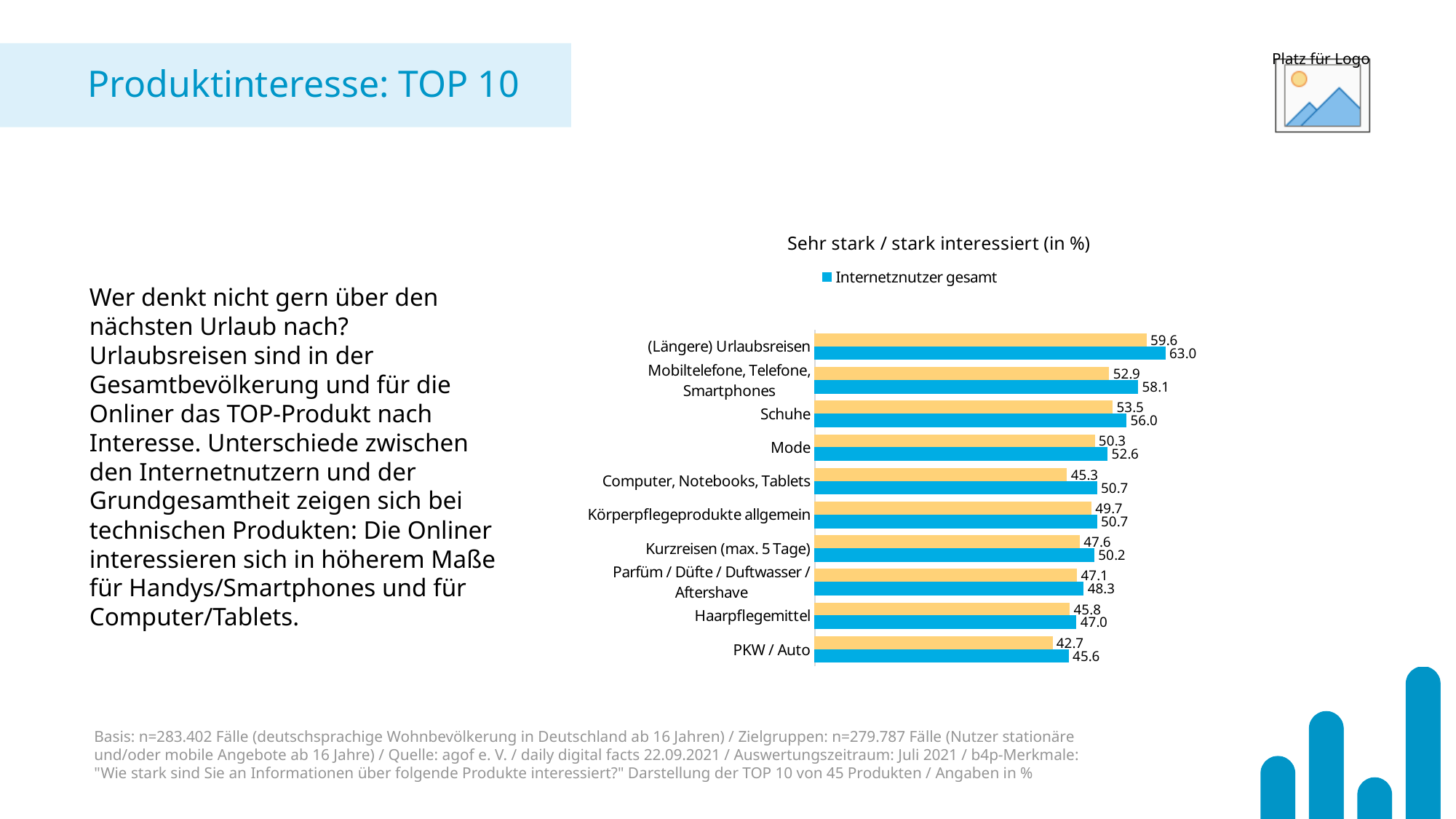
What is the value for Internetznutzer gesamt for Schuhe? 56.0 What is the value shown on the yellow bar for PKW / Auto? 42.7 Which has the larger Internetznutzer gesamt value, Mode or Haarpflegemittel? Mode What is the difference between the Internetznutzer gesamt values for (Längere) Urlaubsreisen and PKW / Auto? 17.4 What is the value for Internetznutzer gesamt for Computer, Notebooks, Tablets? 50.7 What is the value for Internetznutzer gesamt for (Längere) Urlaubsreisen? 63.0 How many series does the legend list? 1 What is the difference between the Internetznutzer gesamt value and the yellow bar value for Mobiltelefone, Telefone, Smartphones? 5.2 Which category has the highest value for Internetznutzer gesamt? (Längere) Urlaubsreisen Which category has the lowest value for Internetznutzer gesamt? PKW / Auto What type of chart is shown on the slide? Bar chart How many product categories are shown in the chart? 10